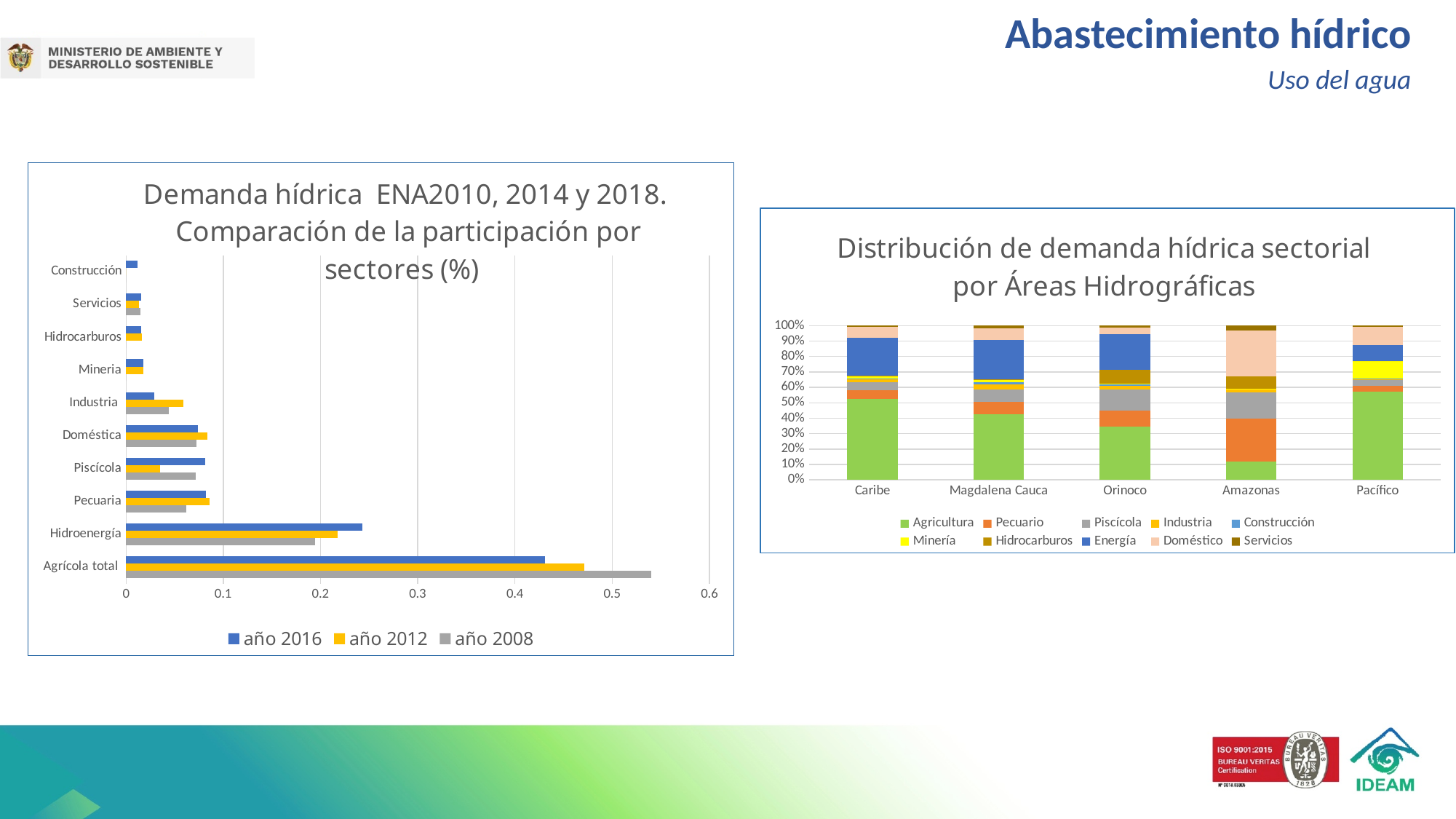
How many series does the legend of the left chart "Demanda hídrica ENA2010, 2014 y 2018" list? 3 In the right chart "Distribución de demanda hídrica sectorial por Áreas Hidrográficas", is the Agricultura share for Amazonas greater or less than 20%? less How many series does the legend of the right chart "Distribución de demanda hídrica sectorial por Áreas Hidrográficas" list? 10 In the left chart "Demanda hídrica ENA2010, 2014 y 2018", which sector has the highest value for año 2016? Agrícola total What kind of chart is the left chart titled "Demanda hídrica ENA2010, 2014 y 2018"? bar chart In the left chart "Demanda hídrica ENA2010, 2014 y 2018", which is larger for Hidroenergía: the año 2016 value or the año 2012 value? año 2016 In the left chart "Demanda hídrica ENA2010, 2014 y 2018", which is larger for Agrícola total: the año 2008 value or the año 2016 value? año 2008 How many hydrographic areas are shown on the x axis of the right chart "Distribución de demanda hídrica sectorial por Áreas Hidrográficas"? 5 In the left chart "Demanda hídrica ENA2010, 2014 y 2018", is the año 2008 value for Agrícola total greater or less than 0.5? greater In the right chart "Distribución de demanda hídrica sectorial por Áreas Hidrográficas", which area has the smallest Agricultura share? Amazonas In the left chart "Demanda hídrica ENA2010, 2014 y 2018", is the año 2016 value for Hidroenergía greater or less than 0.2? greater How many sector categories are shown in the left chart "Demanda hídrica ENA2010, 2014 y 2018"? 10